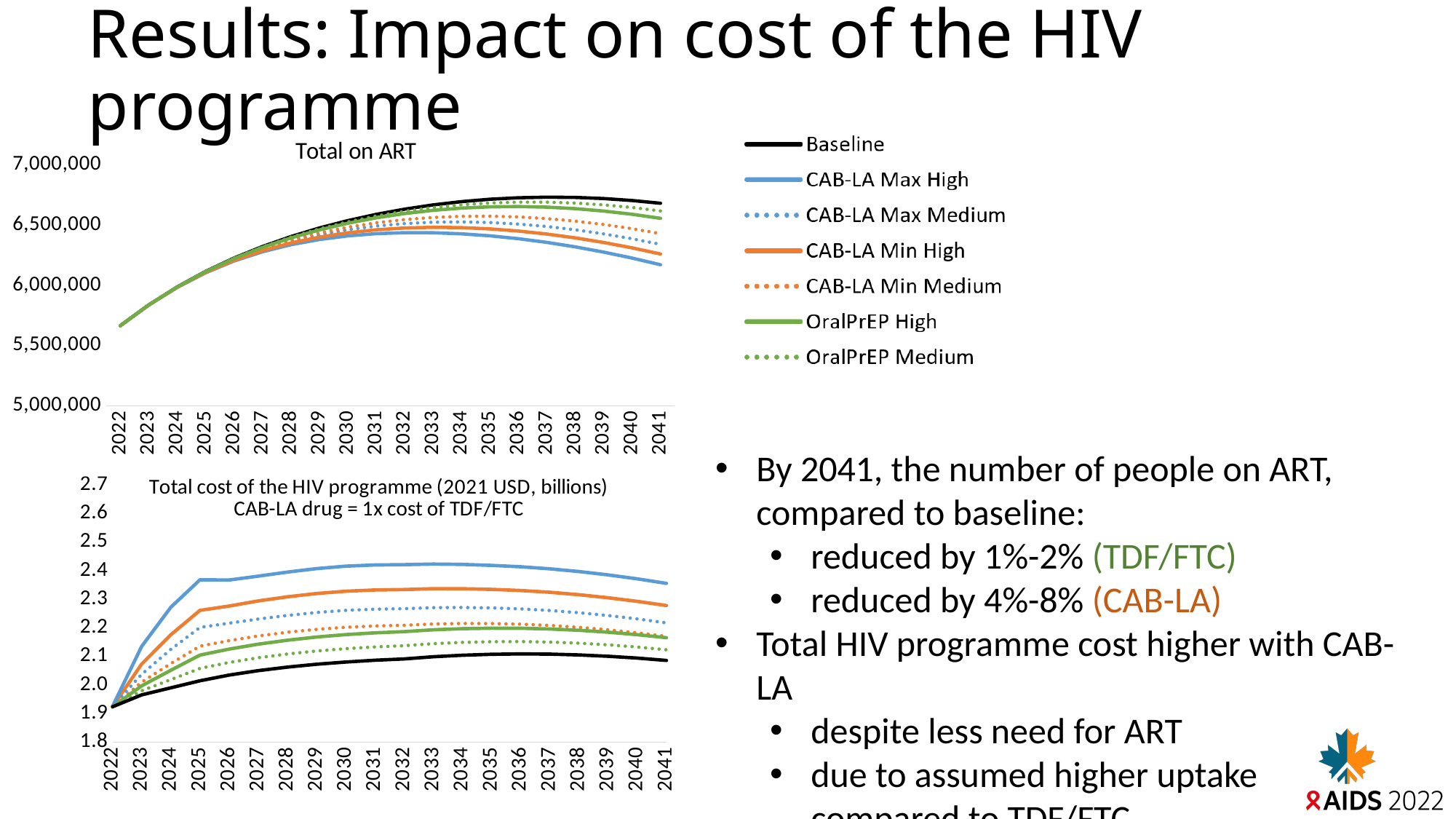
What type of chart is the 'Total on ART' chart? Line chart In the 'Total on ART' chart, which series has the lowest value in 2041? CAB-LA Max High In the 'Total on ART' chart, which series has the highest value in 2041? Baseline In the 'Total on ART' chart, is the CAB-LA Max High value in 2041 greater or less than 6,500,000? less In the 'Total on ART' chart, is the Baseline value in 2041 greater or less than 6,500,000? greater How many series does the legend list for the charts? 7 How many years are shown on the x axis of the 'Total on ART' chart? 20 In the 'Total cost of the HIV programme' chart, is the Baseline value in 2041 greater or less than 2.2? less In the 'Total cost of the HIV programme' chart, which series has the lowest value in 2041? Baseline In the 'Total on ART' chart, does the Baseline series rise or fall from 2022 to 2041? Rises In the 'Total cost of the HIV programme' chart, which series has the highest value in 2041? CAB-LA Max High